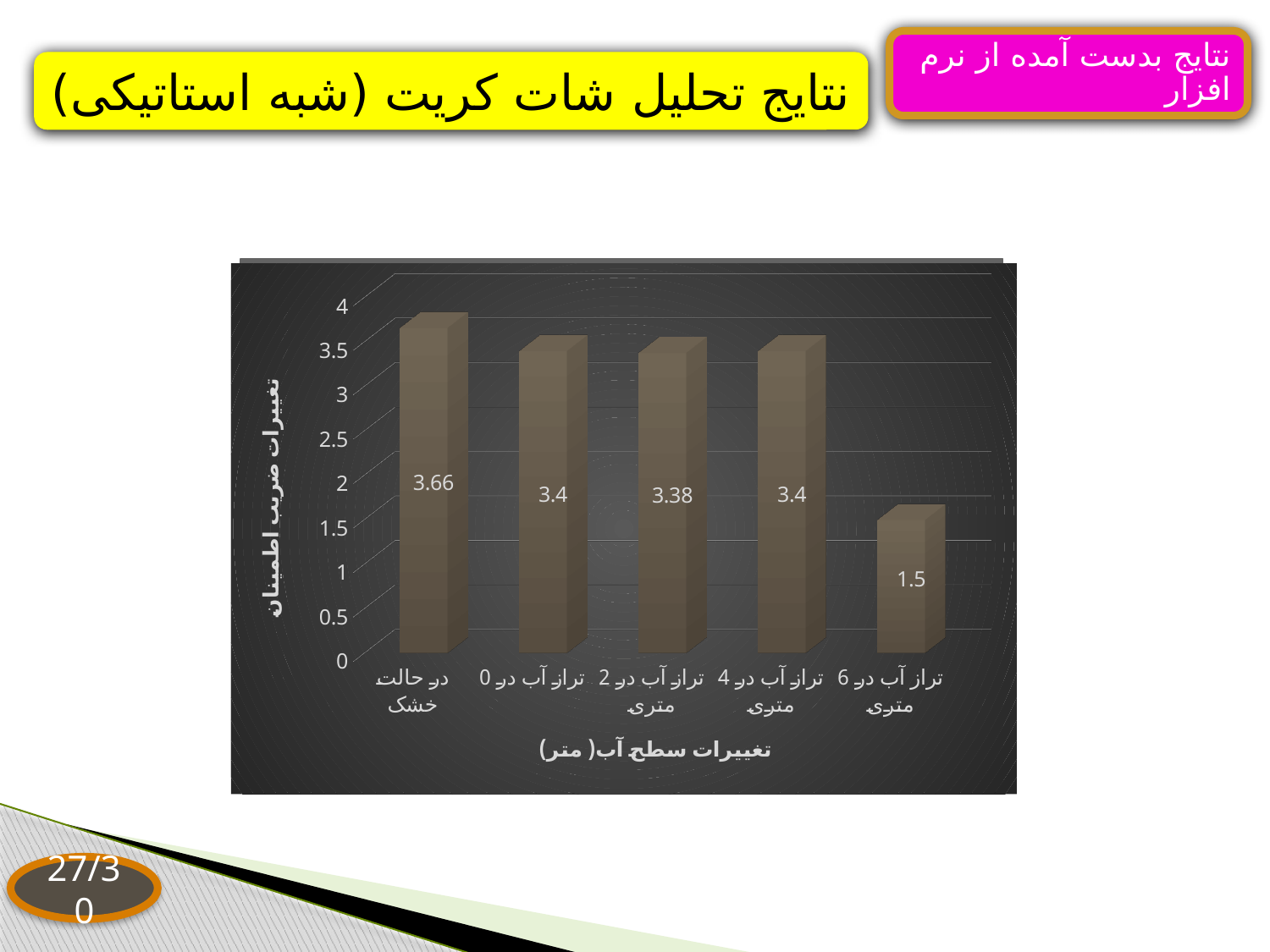
Which category has the highest value? در حالت خشک What kind of chart is shown on the slide? bar chart What is the value for the bar labelled "تراز آب در 6 متری" (water level at 6 m)? 1.5 Is the value for "تراز آب در 6 متری" greater or less than 2? less Which is larger: the value for "در حالت خشک" or the value for "تراز آب در 4 متری"? در حالت خشک What is the value for the bar labelled "تراز آب در 0 متری" (water level at 0 m)? 3.4 What is the label of the horizontal (x) axis of the chart? تغییرات سطح آب (متر) What is the value for the bar labelled "تراز آب در 2 متری" (water level at 2 m)? 3.38 What is the difference between the value for "در حالت خشک" and the value for "تراز آب در 6 متری"? 2.16 How many bars are shown in the chart? 5 Which category has the lowest value? تراز آب در 6 متری What is the value for the bar labelled "در حالت خشک" (dry state)? 3.66